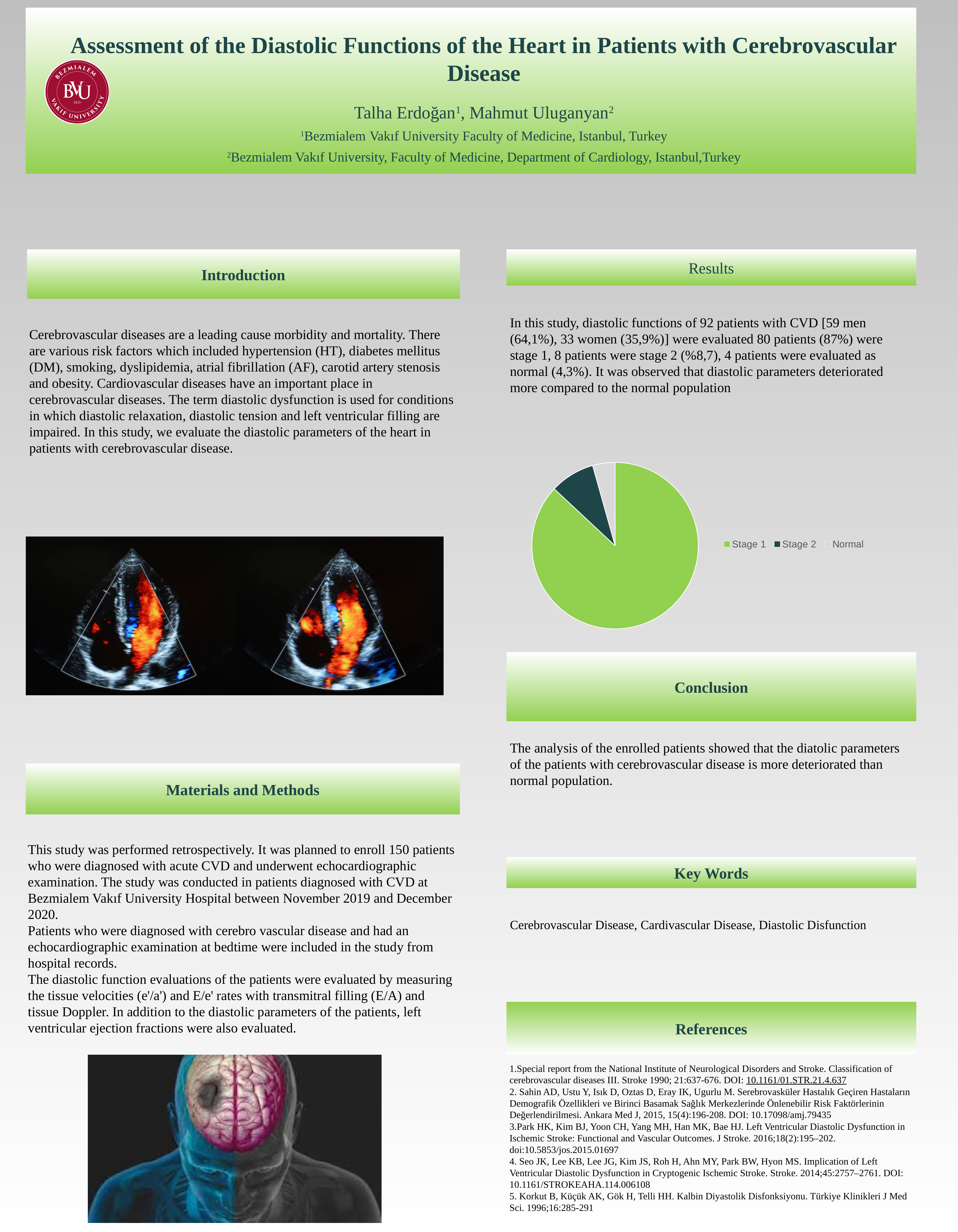
In the pie chart, which slice is larger, Stage 2 or Normal? Stage 2 Which category has the largest slice in the pie chart? Stage 1 How many entries does the legend of the pie chart list? 3 Which category has the smallest slice in the pie chart? Normal What colour is the Stage 1 slice in the pie chart? green What kind of chart is shown in the Results section? pie chart What are the legend entries of the pie chart, in order? Stage 1, Stage 2, Normal In the pie chart, which slice is larger, Stage 1 or Stage 2? Stage 1 How many slices does the pie chart have? 3